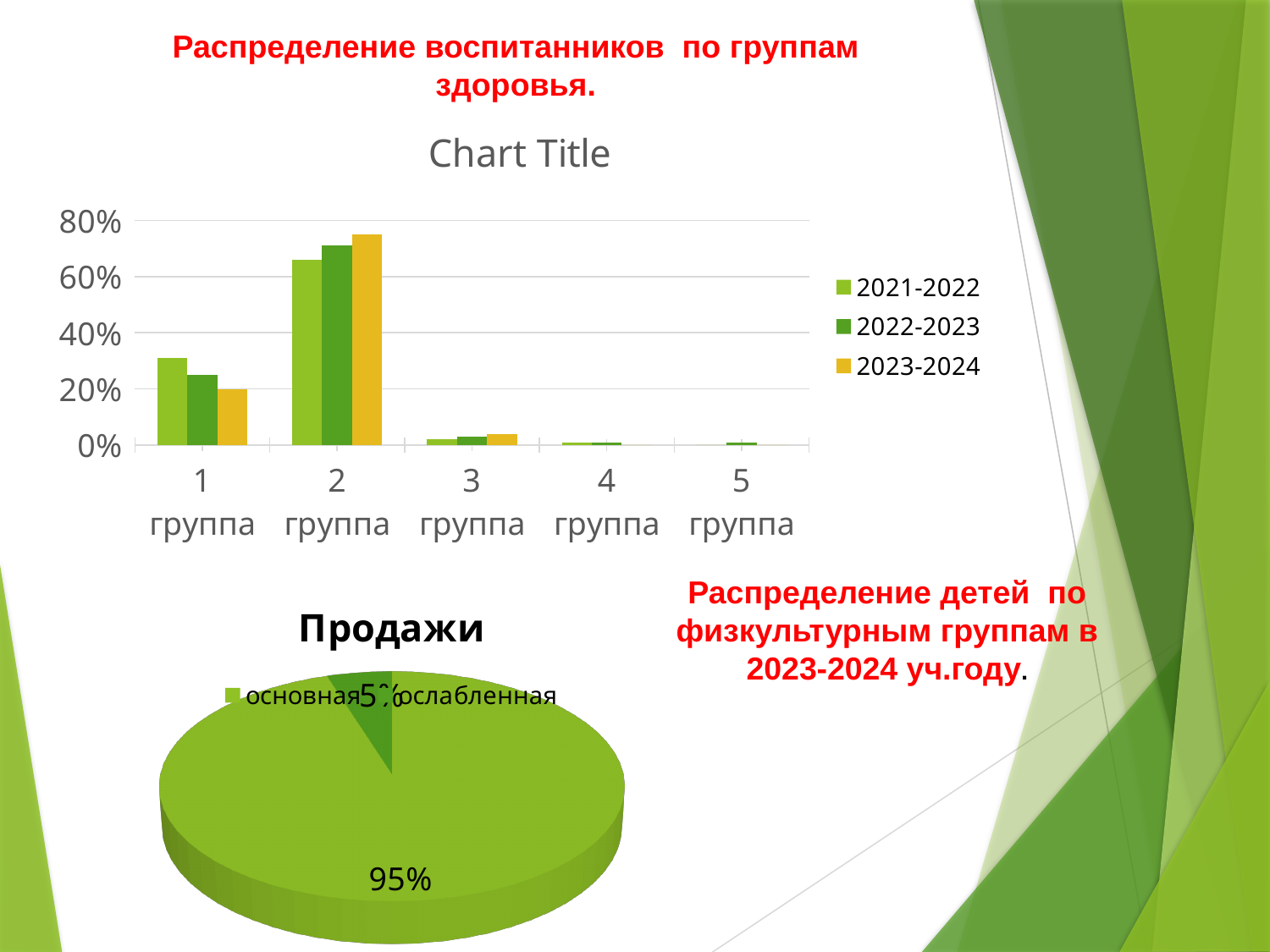
What kind of chart is the chart titled "Chart Title"? bar chart In the chart titled "Chart Title", do the values for 2 группа rise or fall from 2021-2022 to 2023-2024? rise In the chart titled "Chart Title", which category has the highest value for the 2023-2024 series? 2 группа In the chart titled "Chart Title", which is larger for 1 группа: the 2021-2022 value or the 2023-2024 value? 2021-2022 How many categories are shown on the x axis of the chart titled "Chart Title"? 5 How many series does the legend of the chart titled "Chart Title" list? 3 In the chart titled "Chart Title", which series is shown in yellow? 2023-2024 In the chart titled "Chart Title", is the value for 1 группа in 2021-2022 greater or less than 40%? less In the pie chart titled "Продажи", what share does the основная slice have? 95% In the chart titled "Chart Title", is the value for 2 группа in 2023-2024 greater or less than 60%? greater What kind of chart is the chart titled "Продажи"? pie chart In the pie chart titled "Продажи", what share does the ослабленная slice have? 5%